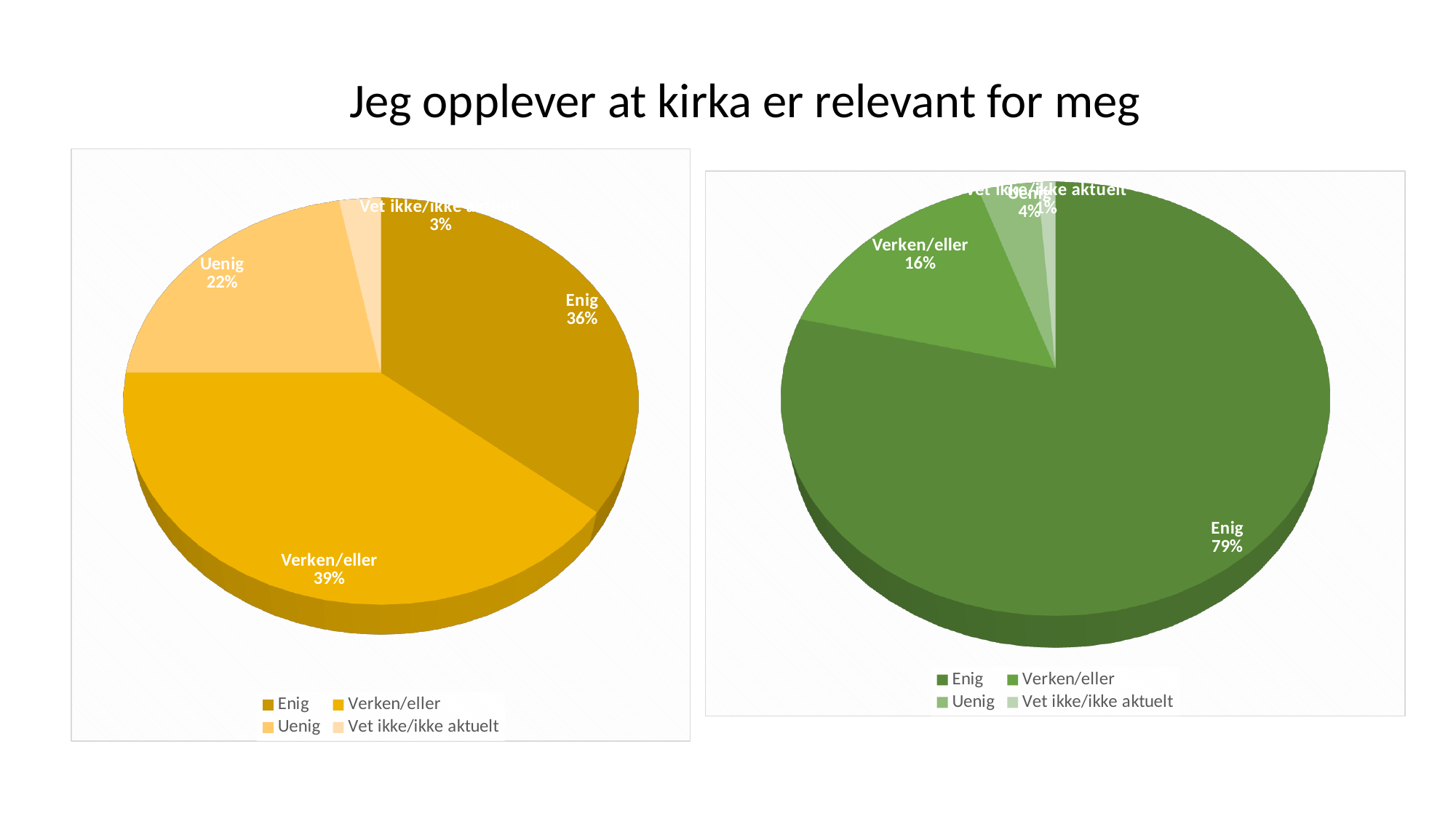
How many categories does the legend of the right pie chart list? 4 In the right pie chart, what is the difference between the Enig and Verken/eller shares? 63% In the left pie chart, what is the difference between the Enig and Uenig shares? 14% In the left pie chart, which category has the smallest slice? Vet ikke/ikke aktuelt In the left pie chart, what share does Uenig have? 22% Which chart has the larger share for Enig, the left pie chart or the right pie chart? the right pie chart In the right pie chart, which category has the smallest slice? Vet ikke/ikke aktuelt In the right pie chart, what share does Enig have? 79% In the left pie chart, what share does Verken/eller have? 39% In the right pie chart, what share does Verken/eller have? 16% In the left pie chart, which category has the largest slice? Verken/eller What type of chart is shown on the left of the slide? pie chart